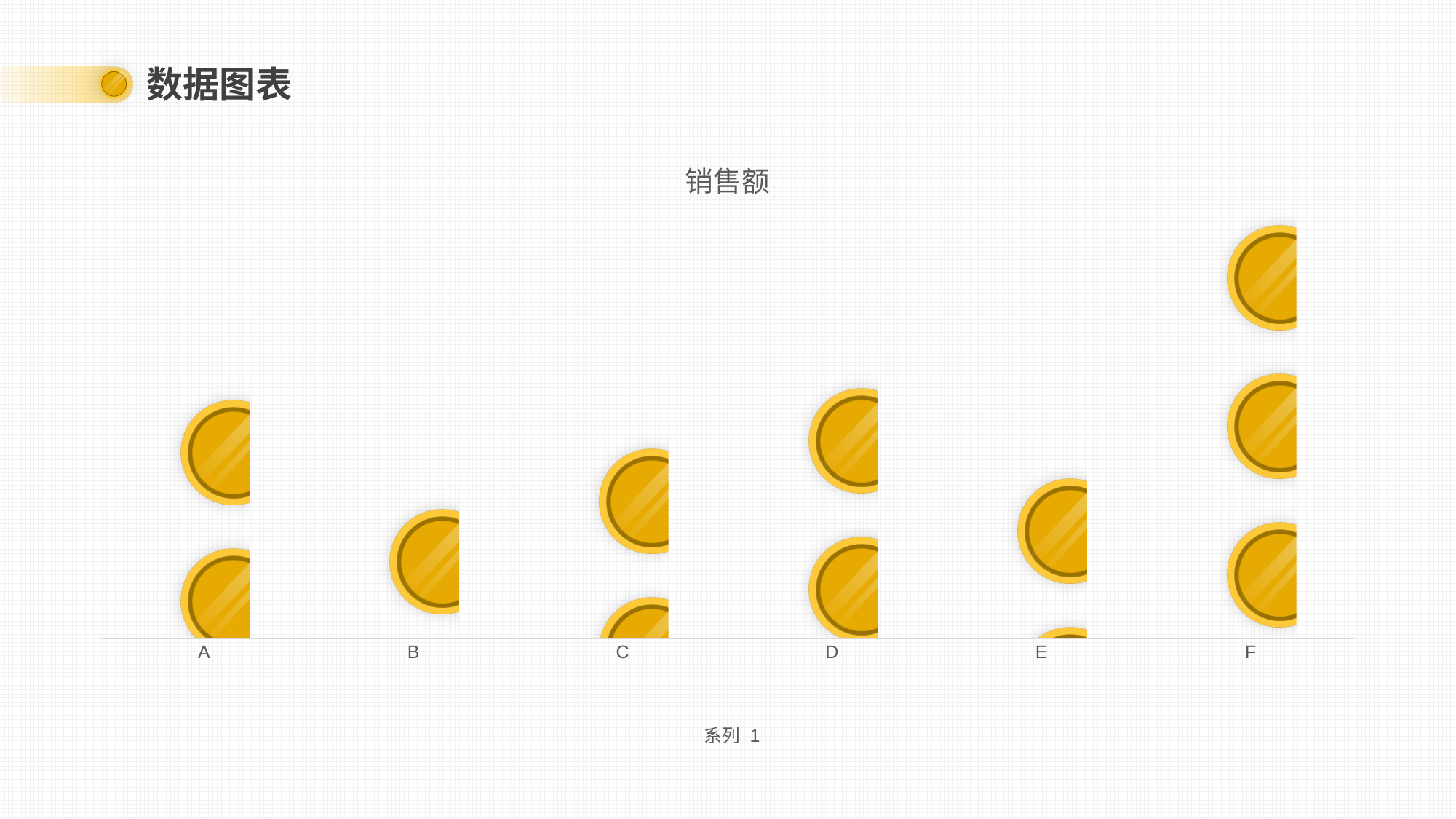
What kind of chart is shown on the slide? bar chart Which category has the lowest value in the chart? B What is the name of the series shown in the legend? 系列 1 How many categories are shown on the x axis of the chart? 6 Which is larger, the value for D or the value for B? D Which is larger, the value for F or the value for A? F What is the title of the chart? 销售额 Which category has the highest value in the chart? F Which is larger, the value for F or the value for D? F How many series does the chart's legend list? 1